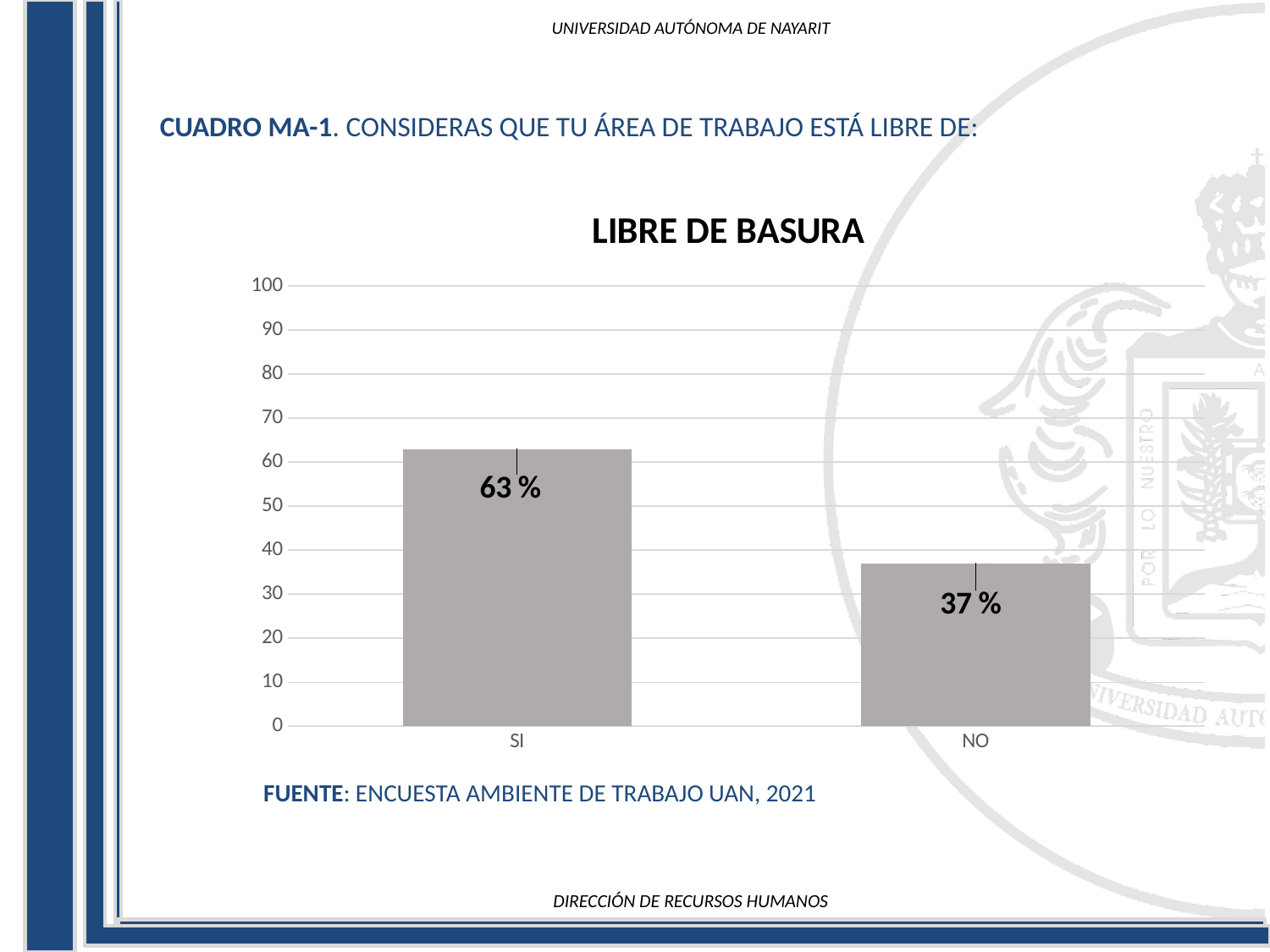
What is the value for SI? 63 % What kind of chart is shown on the slide? bar chart What is the title of the chart? LIBRE DE BASURA Is the value for NO greater or less than 40? less Which category has the highest value? SI How many categories are shown on the x axis? 2 What is the difference between the values for SI and NO? 26 % Which is larger, the value for SI or the value for NO? SI Which category has the lowest value? NO Is the value for SI greater or less than 50? greater What is the maximum value shown on the y axis? 100 What is the value for NO? 37 %